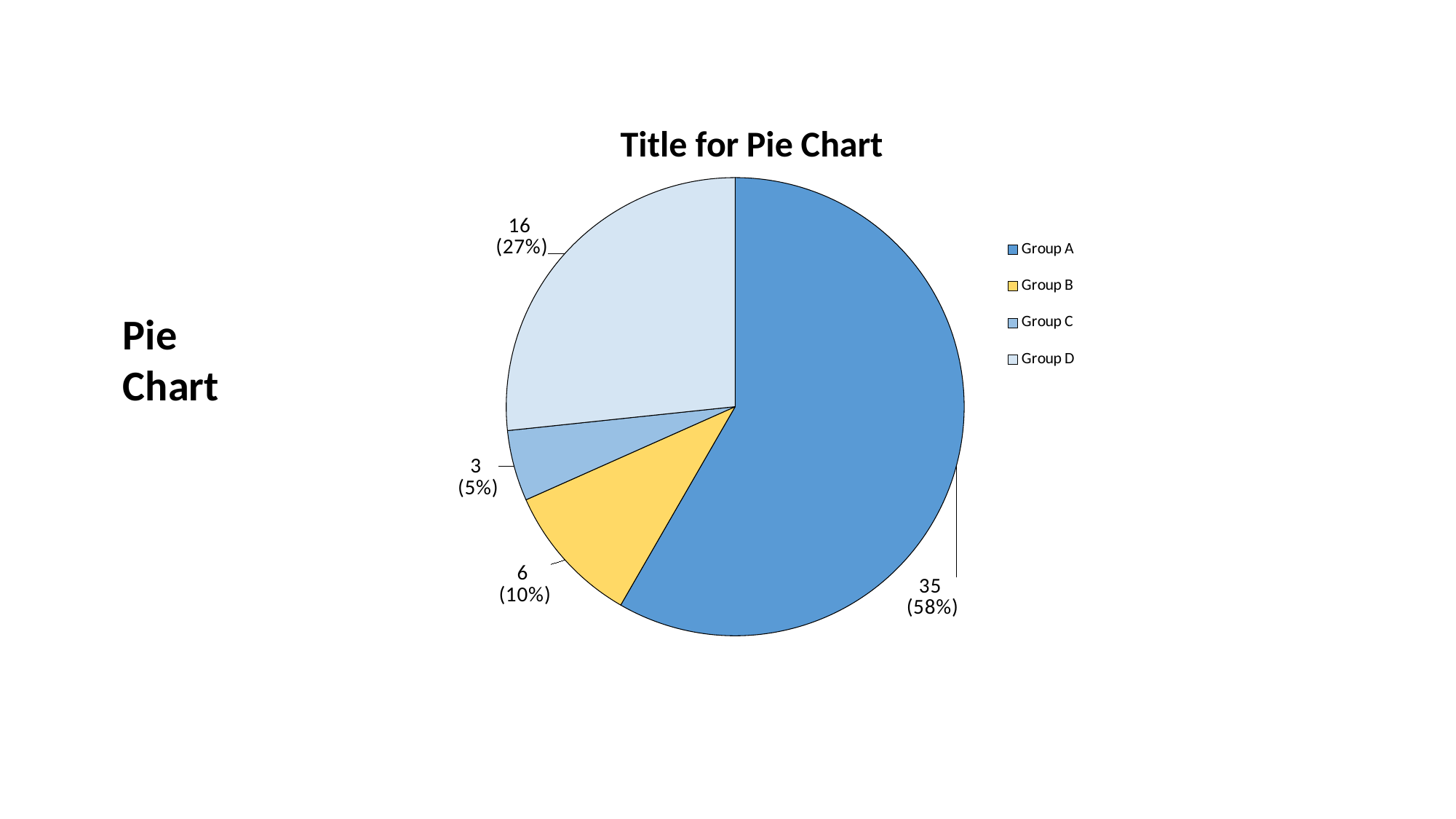
What is the difference between the values for Group A and Group D? 19 What is the value for Group B? 6 What is the value for Group D? 16 What is the value for Group C? 3 What share of the pie does Group D represent? 27% How many groups does the legend list? 4 What kind of chart is shown on the slide? pie chart What is the value for Group A? 35 Which group has the smallest slice? Group C What is the title of the chart? Title for Pie Chart What share of the pie does Group A represent? 58% Which group has the largest slice? Group A